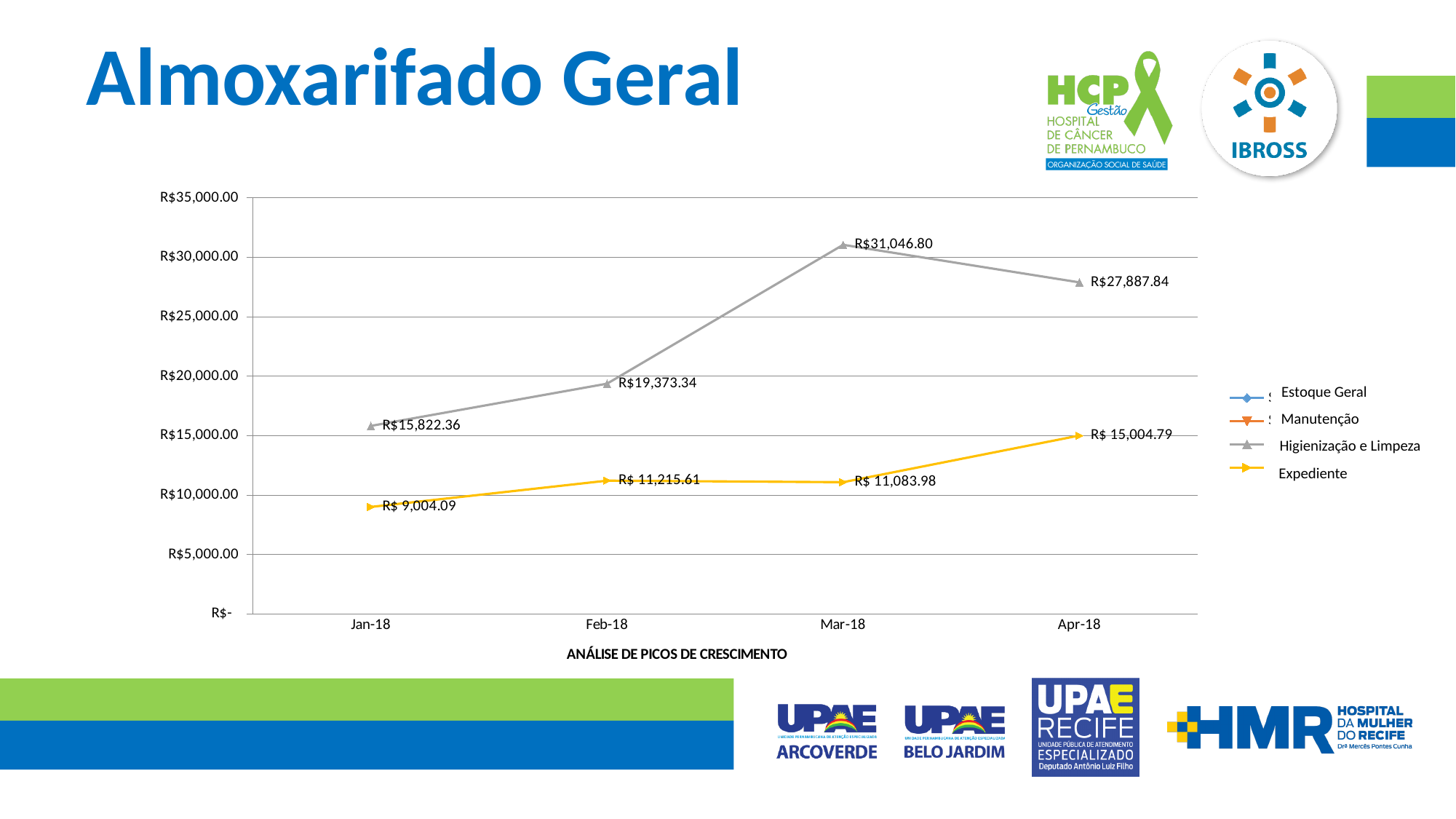
In which month is Higienização e Limpeza highest? Mar-18 What is the value for Higienização e Limpeza in Mar-18? R$31,046.80 In which month is Expediente lowest? Jan-18 What is the value for Expediente in Apr-18? R$ 15,004.79 What is the difference between Higienização e Limpeza and Expediente in Mar-18? R$ 19,962.82 Which is larger in Apr-18, Higienização e Limpeza or Expediente? Higienização e Limpeza How many series does the legend list? 4 By how much did Expediente increase from Jan-18 to Apr-18? R$ 6,000.70 What kind of chart is shown on the slide? Line chart What is the value for Higienização e Limpeza in Feb-18? R$19,373.34 What is the value for Expediente in Jan-18? R$ 9,004.09 How many months are shown on the x axis? 4